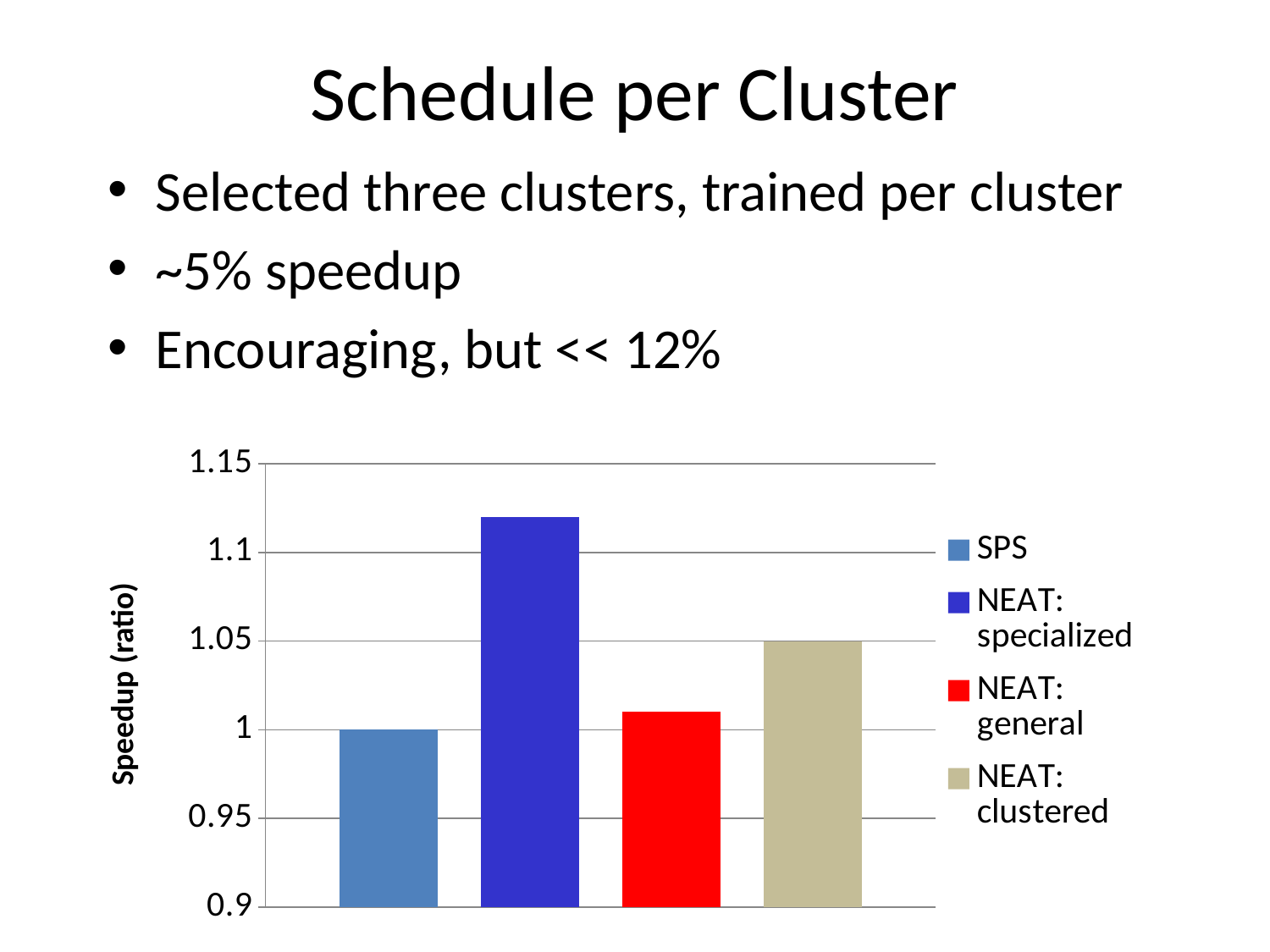
Is the speedup ratio for NEAT: general greater or less than 1.05? less What colour is the bar for NEAT: general? red Is the speedup ratio for NEAT: specialized greater or less than 1.15? less Which series has the highest speedup ratio? NEAT: specialized What is the speedup ratio for SPS? 1 Which has a higher speedup ratio, NEAT: specialized or NEAT: clustered? NEAT: specialized Is the speedup ratio for NEAT: specialized greater or less than 1.1? greater What is the speedup ratio for NEAT: clustered? 1.05 Which has a higher speedup ratio, NEAT: clustered or NEAT: general? NEAT: clustered How many series does the legend list? 4 What is the label of the vertical axis? Speedup (ratio) What kind of chart is shown on the slide? bar chart